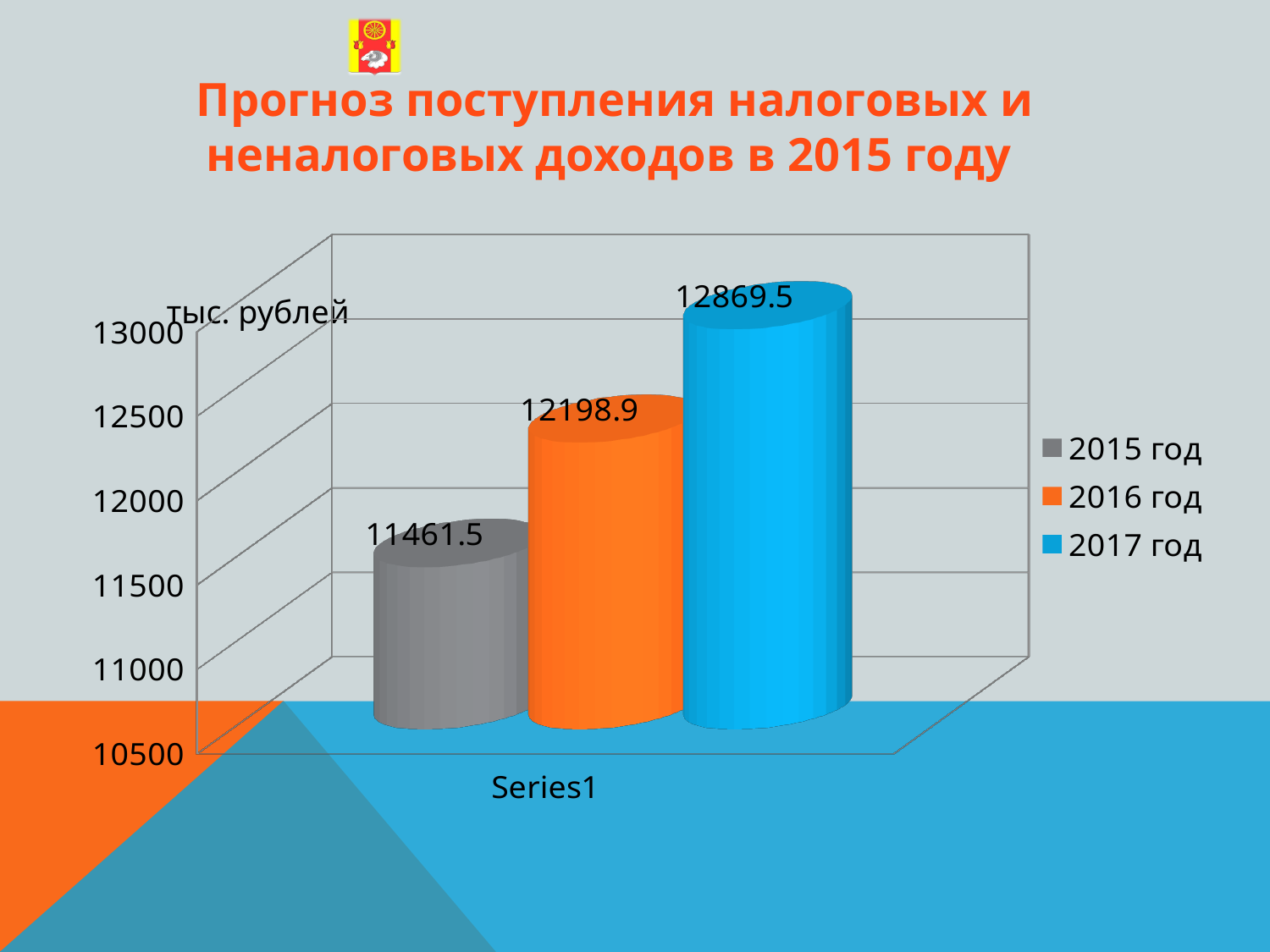
What is the difference between the values for 2017 год and 2015 год? 1408 Which is larger, the value for 2016 год or the value for 2017 год? 2017 год What unit is shown on the vertical axis label? тыс. рублей What is the value for 2016 год? 12198.9 Is the value for 2015 год greater or less than 12000? less What is the value for 2017 год? 12869.5 Which year has the highest value? 2017 год What kind of chart is shown on the slide? bar chart What is the difference between the values for 2016 год and 2015 год? 737.4 Which year has the lowest value? 2015 год How many series does the legend list? 3 What is the value for 2015 год? 11461.5